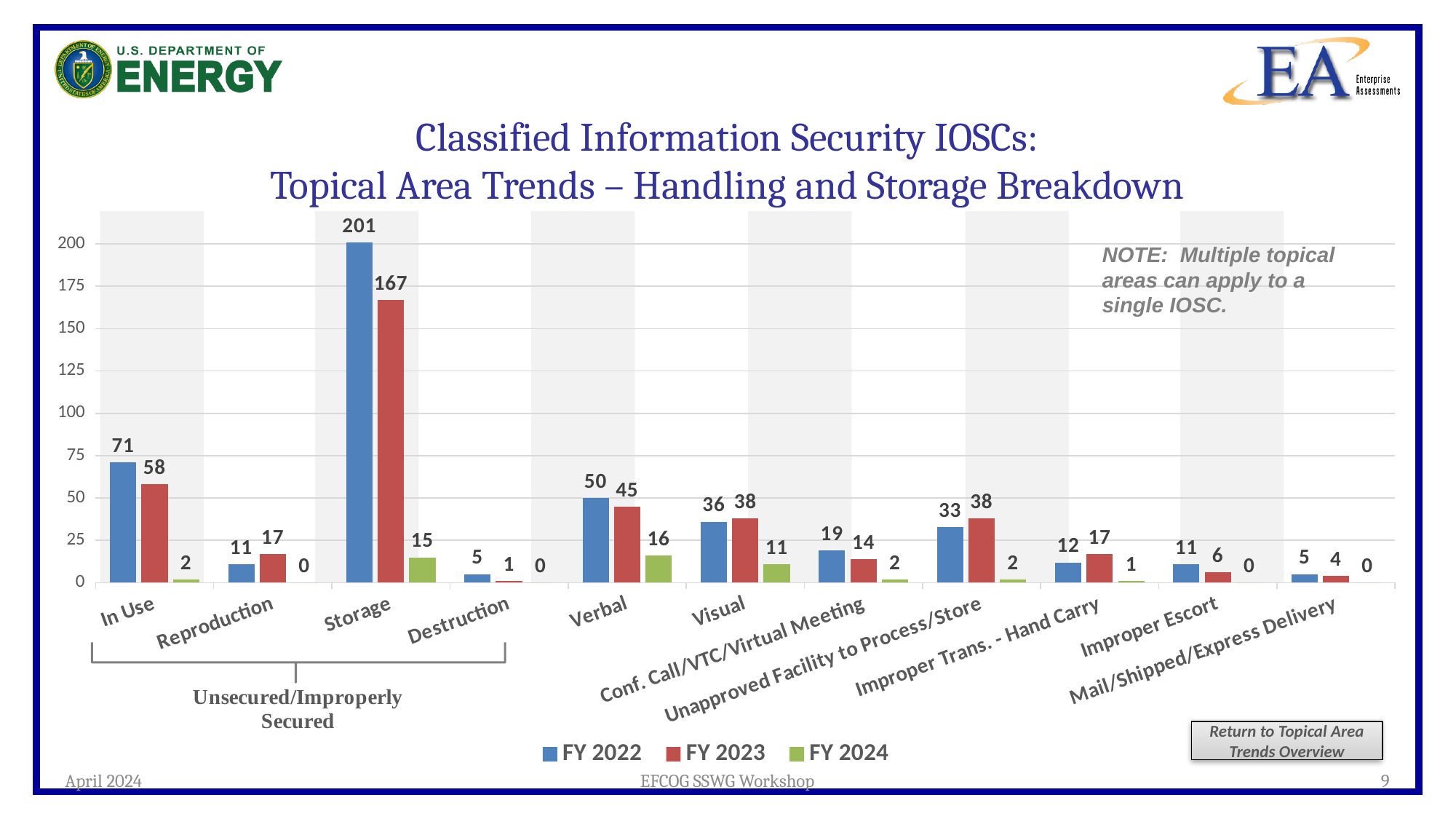
What is the difference between the FY 2022 and FY 2023 values for Storage? 34 Which category has the highest FY 2023 value? Storage Which category has the lowest FY 2022 value? Destruction and Mail/Shipped/Express Delivery (both 5) Which categories are grouped under the bracket labelled Unsecured/Improperly Secured? In Use, Reproduction, Storage, Destruction How many series does the legend list? 3 What is the FY 2024 value for Visual? 11 Which is larger for Unapproved Facility to Process/Store: the FY 2022 value or the FY 2023 value? FY 2023 What is the FY 2023 value for Verbal? 45 Is the FY 2022 value for In Use greater or less than 50? greater What is the FY 2022 value for Storage? 201 What kind of chart is shown on the slide? Bar chart How many categories are shown on the x axis? 11